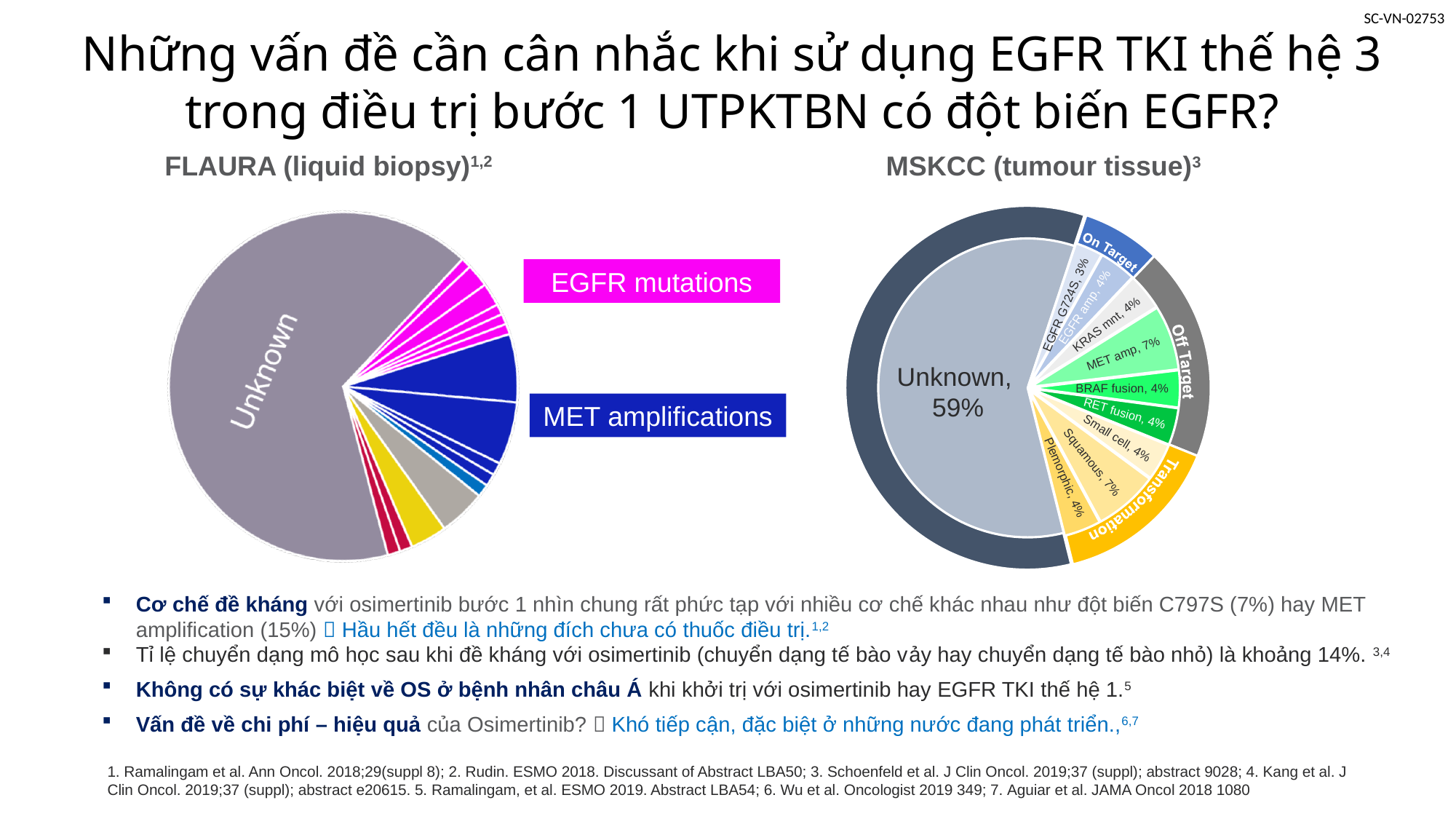
In the MSKCC (tumour tissue) pie chart, what is the value for EGFR G724S? 3% In the MSKCC (tumour tissue) pie chart, what are the three group labels on the outer ring? On Target, Off Target, Transformation In the MSKCC (tumour tissue) pie chart, which is larger, MET amp or KRAS mnt? MET amp In the MSKCC (tumour tissue) pie chart, what share is labelled for Unknown? 59% How many labelled slices does the MSKCC (tumour tissue) pie chart have? 10 In the MSKCC (tumour tissue) pie chart, what is the value for Squamous? 7% What type of chart is used for FLAURA (liquid biopsy)? Pie chart In the MSKCC (tumour tissue) pie chart, what is the difference between the Unknown share and the MET amp share? 52% In the MSKCC (tumour tissue) pie chart, which slice is the smallest? EGFR G724S In the MSKCC (tumour tissue) pie chart, which slice is the largest? Unknown In the MSKCC (tumour tissue) pie chart, what is the value for BRAF fusion? 4% In the MSKCC (tumour tissue) pie chart, what is the value for MET amp? 7%